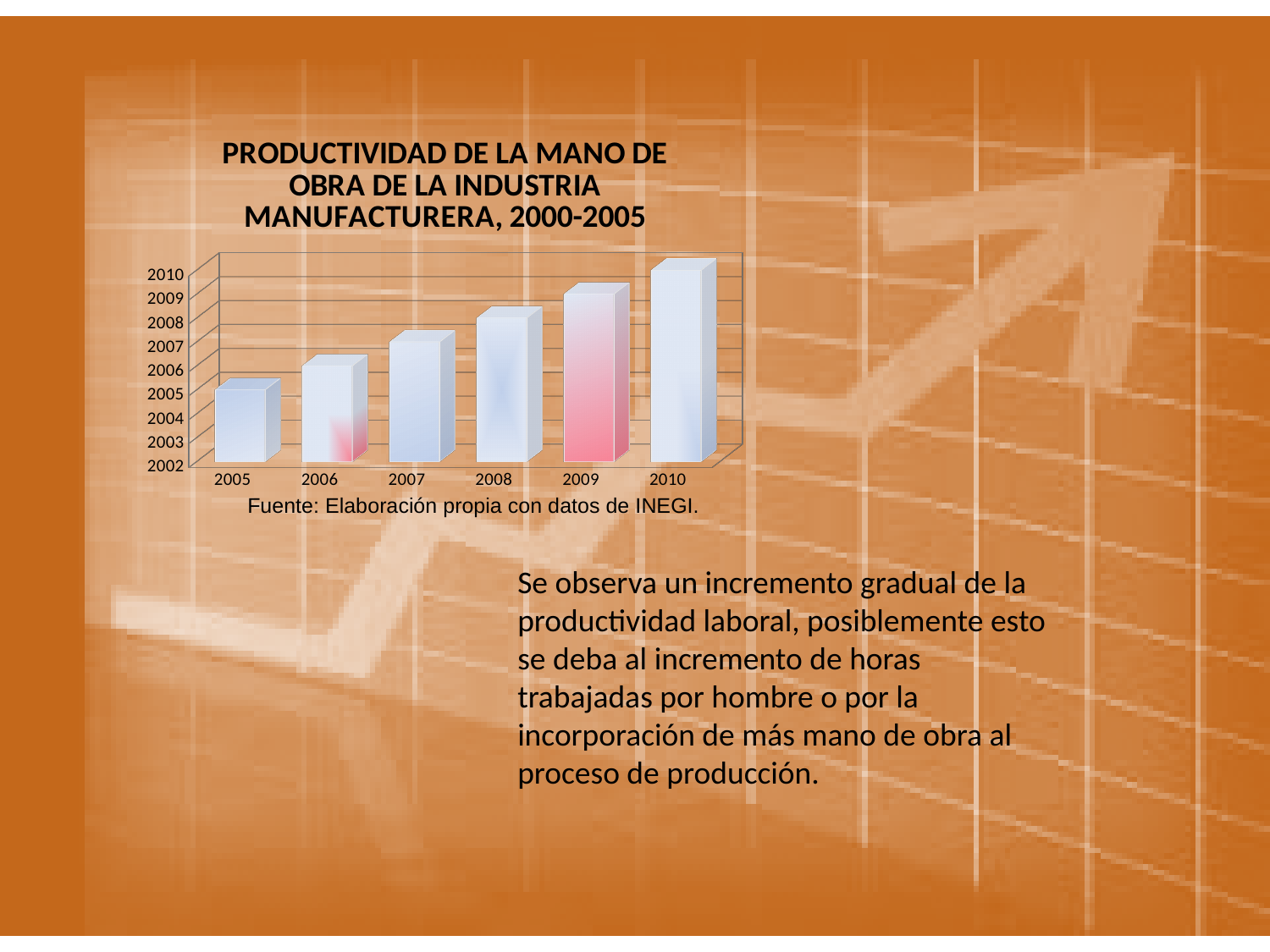
Is the value for 2010 greater or less than 2008 on the vertical axis? greater Which bar is taller, 2006 or 2005? 2006 Is the value for 2005 greater or less than 2008 on the vertical axis? less What is the title of the chart? PRODUCTIVIDAD DE LA MANO DE OBRA DE LA INDUSTRIA MANUFACTURERA, 2000-2005 Is the value for 2009 greater or less than 2006 on the vertical axis? greater Which year has the shortest bar in the chart? 2005 Which year has the tallest bar in the chart? 2010 Do the bar values rise or fall from 2005 to 2010? rise What source is cited below the chart? Elaboración propia con datos de INEGI. How many bars (categories) does the chart show? 6 Which bar is taller, 2007 or 2009? 2009 What kind of chart is shown on the slide? bar chart